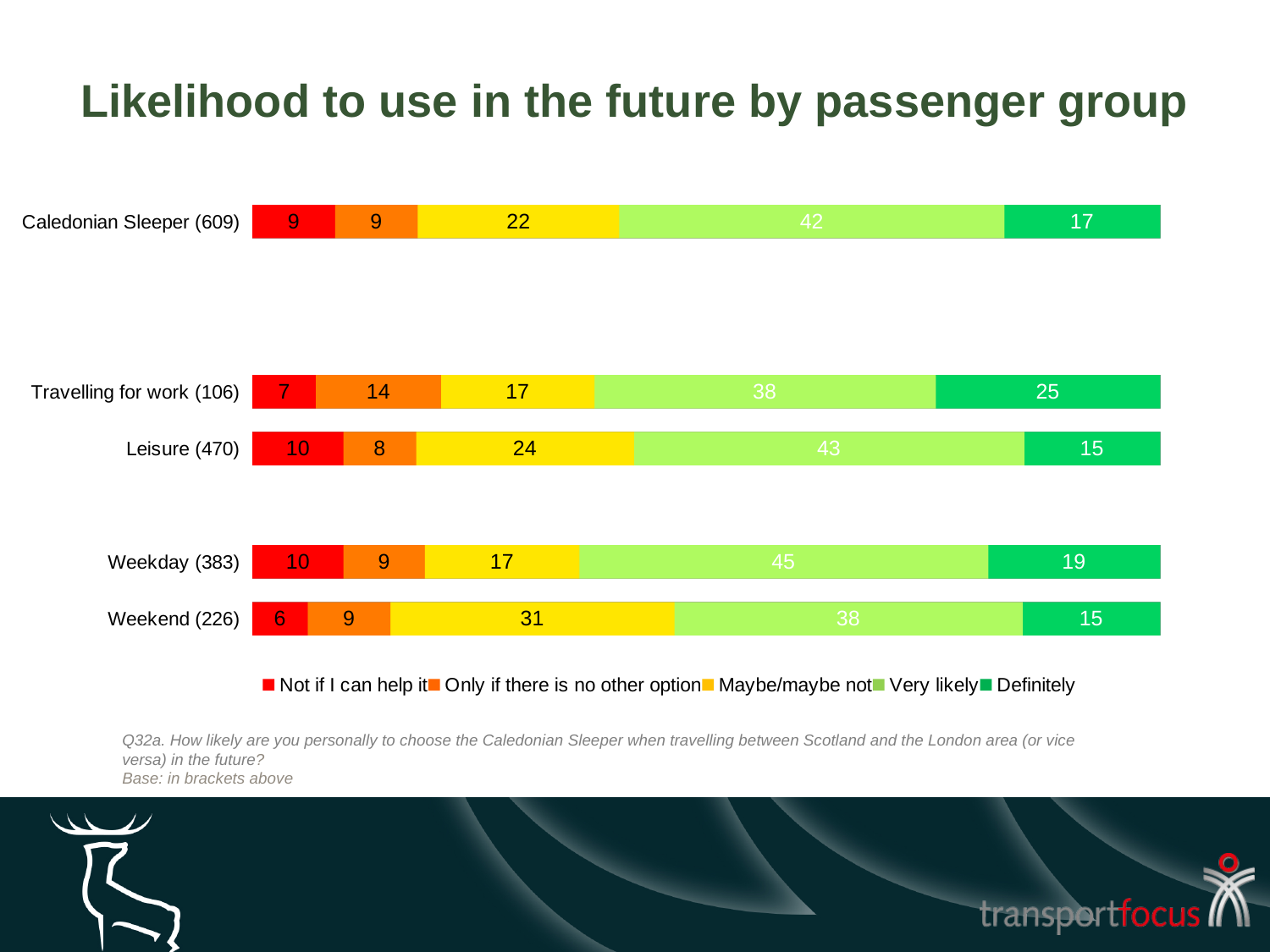
What is the 'Not if I can help it' value for Caledonian Sleeper (609)? 9 How many series does the legend list? 5 How many passenger groups are shown in the chart? 5 What is the 'Very likely' value for Weekday (383)? 45 What is the difference between the 'Maybe/maybe not' values for Weekend (226) and Weekday (383)? 14 What is the total of the stacked bar for Leisure (470)? 100 Which passenger group has the lowest 'Not if I can help it' value? Weekend (226) What is the 'Definitely' value for Travelling for work (106)? 25 What is the 'Maybe/maybe not' value for Weekend (226)? 31 Which is larger: the 'Very likely' value for Leisure (470) or for Travelling for work (106)? Leisure (470) What kind of chart is shown on the slide? Stacked bar chart Which passenger group has the highest 'Definitely' value? Travelling for work (106)